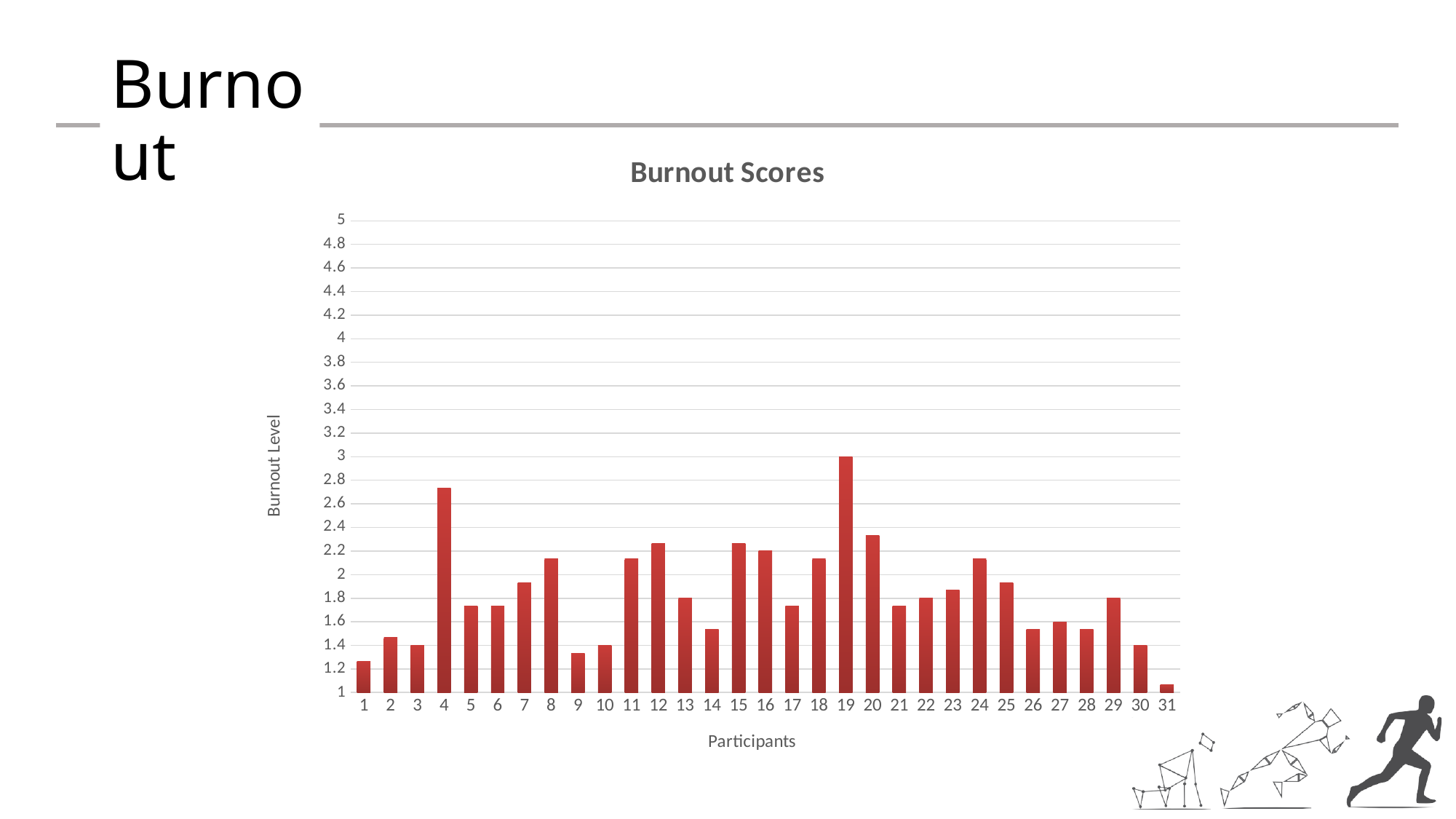
What is the burnout score for participant 19? 3 Is the burnout score for participant 20 greater or less than 2.2? greater What is the title of the chart? Burnout Scores Is the burnout score for participant 31 greater or less than 1.2? less Which participant has the highest burnout score? 19 Is the burnout score for participant 4 greater or less than 2.6? greater What type of chart is shown on the slide? Bar chart Which participant has a higher burnout score, participant 4 or participant 20? Participant 4 How many participants are plotted on the chart? 31 Which participant has the lowest burnout score? 31 What is the label of the vertical axis? Burnout Level Which participant has a higher burnout score, participant 2 or participant 9? Participant 2